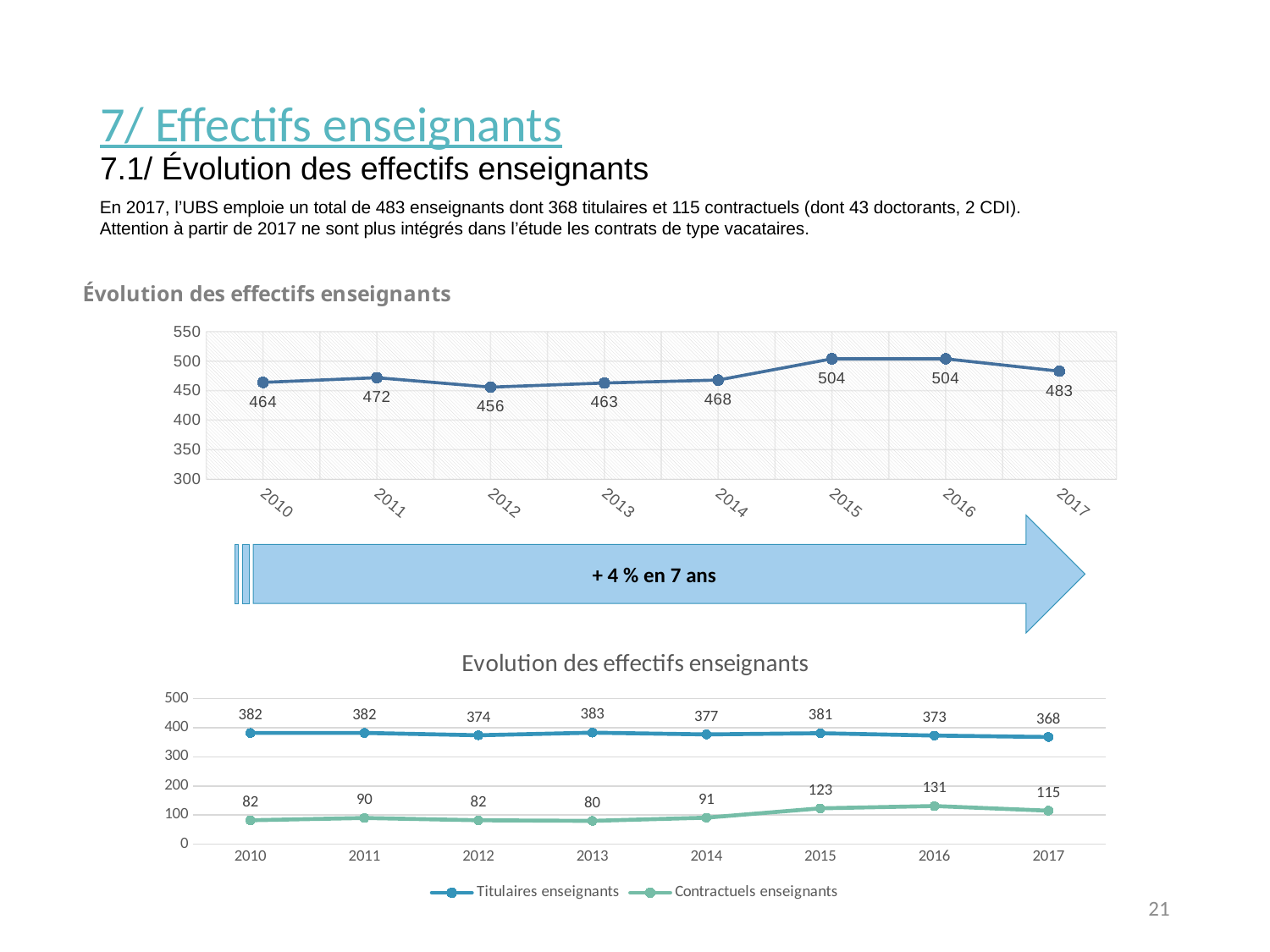
In the bottom chart, which year has the lowest value for Titulaires enseignants? 2017 In the bottom chart, what is the value for Contractuels enseignants in 2016? 131 In the top chart, how many years are plotted on the x axis? 8 In the top chart, is the value for 2015 greater or less than 500? greater In the top chart, what is the value for 2012? 456 In the bottom chart, what is the value for Titulaires enseignants in 2013? 383 In the bottom chart, how many series does the legend list? 2 In the top chart, which year has the lowest value? 2012 In the bottom chart, which year has the highest value for Contractuels enseignants? 2016 In the top chart, what is the difference between the values for 2017 and 2010? 19 In the bottom chart, what is the difference between Titulaires enseignants and Contractuels enseignants in 2017? 253 What type of chart is the top chart? line chart